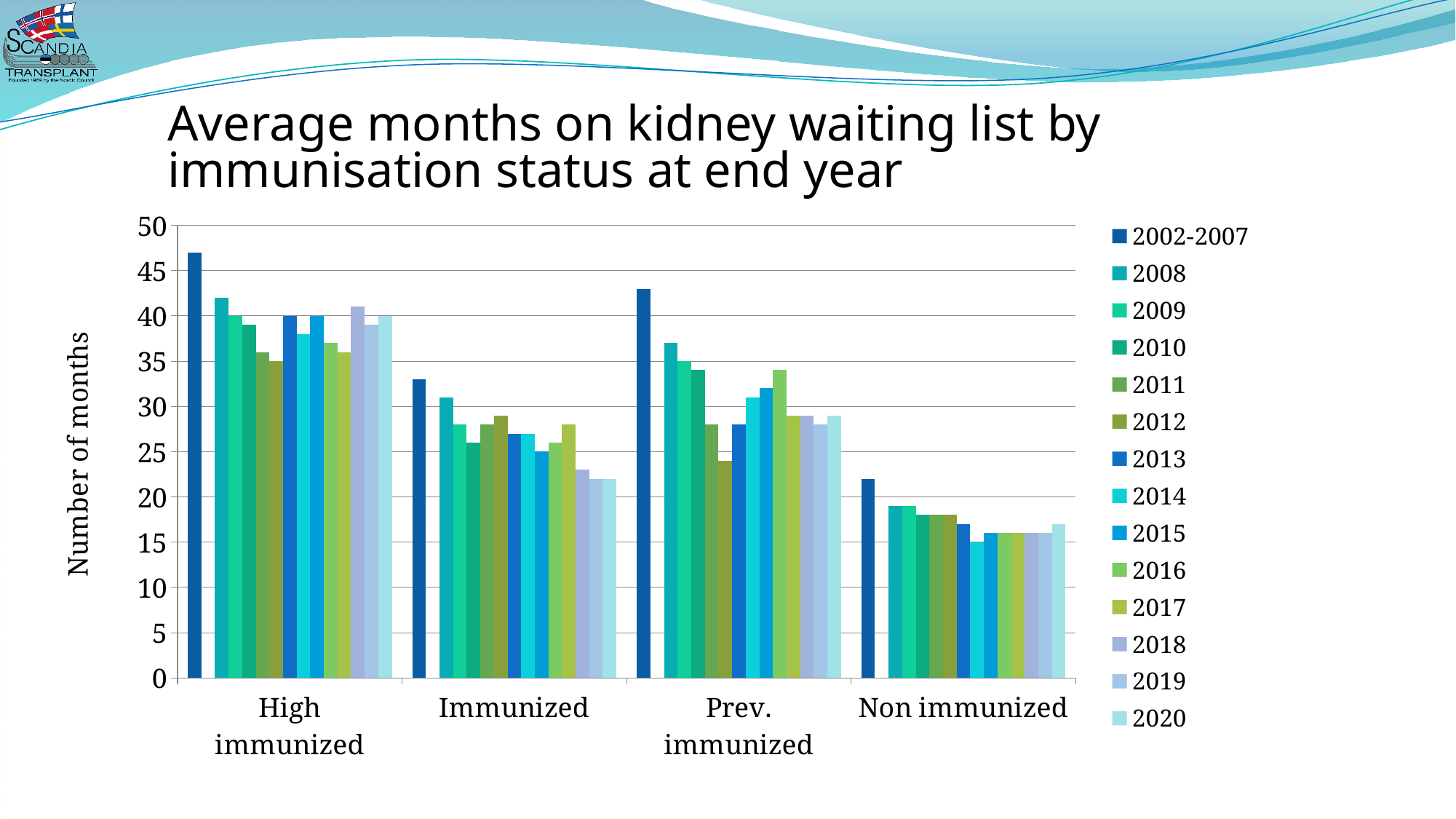
How many immunisation status categories are shown on the x axis? 4 Within the High immunized category, which series has the highest value? 2002-2007 Is the 2002-2007 value for Prev. immunized greater or less than 40? greater What is the label of the y axis? Number of months Is the 2020 value for Immunized greater or less than 25? less For the 2002-2007 series, which is larger: High immunized or Immunized? High immunized Which category has the lowest bars overall? Non immunized What kind of chart is shown on the slide? bar chart Is the 2002-2007 value for Non immunized greater or less than 20? greater Which category has the tallest bar overall? High immunized Which legend entry covers a range of years rather than a single year? 2002-2007 How many series does the legend list? 14